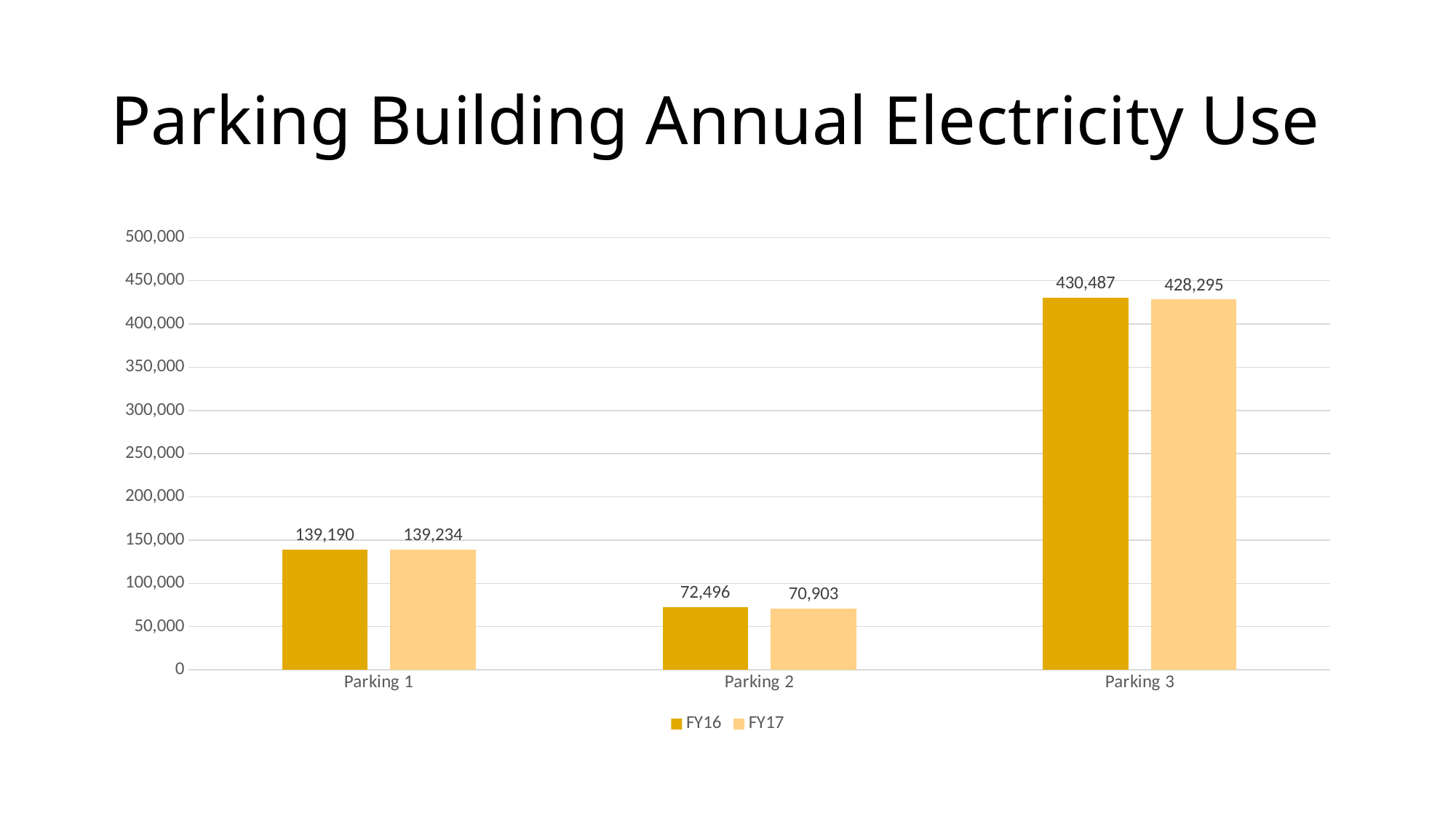
What is the difference between the FY16 and FY17 values for Parking 3? 2,192 What is the FY16 value for Parking 2? 72,496 What is the difference between the FY16 and FY17 values for Parking 2? 1,593 What is the title of the slide? Parking Building Annual Electricity Use What kind of chart is shown on the slide? Bar chart How many series does the legend list? 2 What is the FY17 value for Parking 3? 428,295 How many parking buildings are shown on the x axis? 3 What is the FY16 value for Parking 1? 139,190 Which parking building has the highest FY16 value? Parking 3 Which parking building has the lowest FY17 value? Parking 2 Which is larger, the FY16 value for Parking 1 or the FY16 value for Parking 2? Parking 1